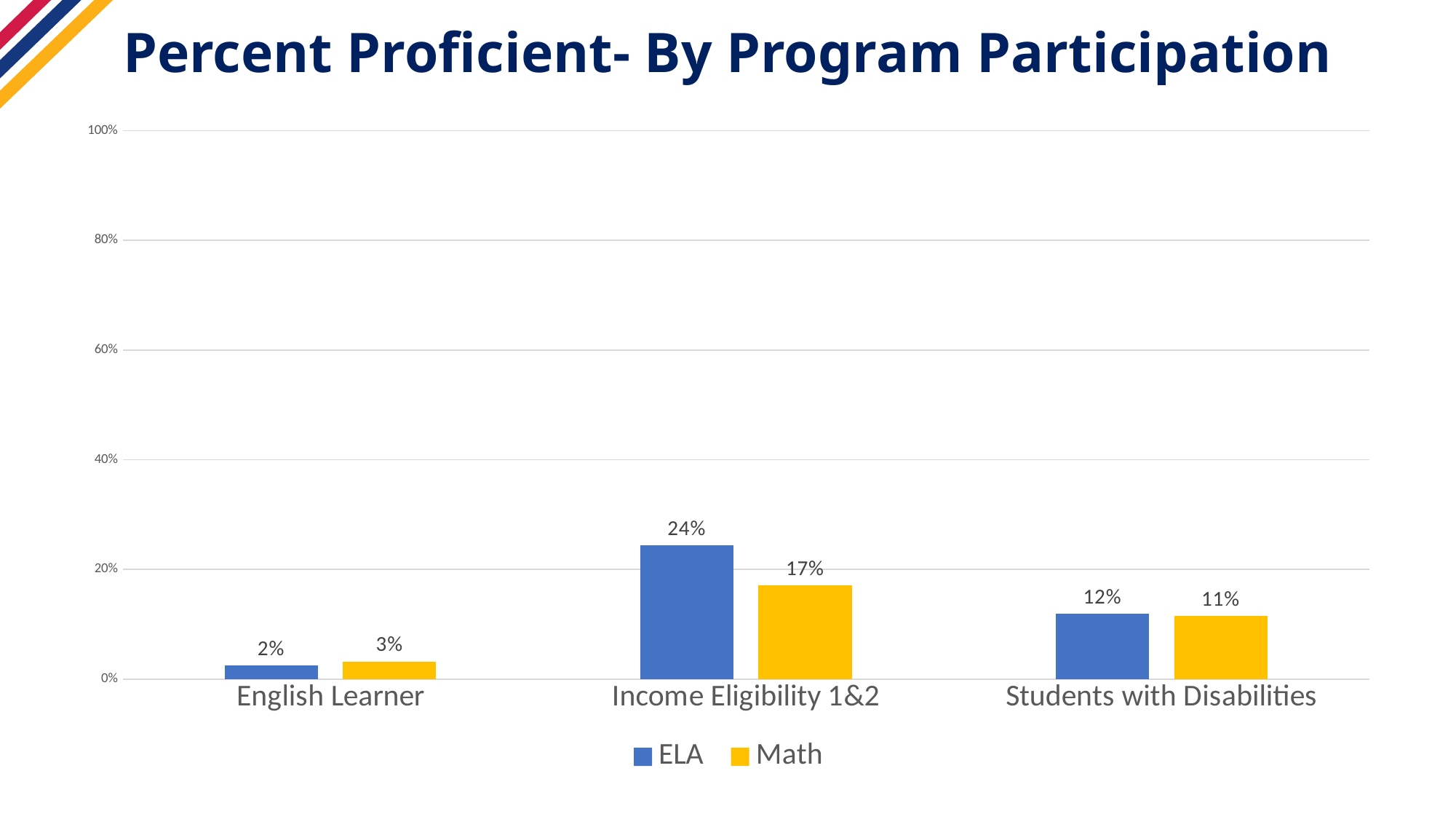
What is the ELA value for Income Eligibility 1&2? 24% What is the difference between the ELA and Math values for Income Eligibility 1&2? 7% Which category has the lowest Math value? English Learner What kind of chart is shown on the slide? bar chart What is the Math value for Students with Disabilities? 11% Is the ELA value for Income Eligibility 1&2 greater or less than 20%? greater Which category has the highest ELA value? Income Eligibility 1&2 What is the title of the chart? Percent Proficient- By Program Participation What is the Math value for English Learner? 3% How many categories are shown on the x axis? 3 Which is larger for Students with Disabilities, the ELA value or the Math value? ELA How many series does the legend list? 2